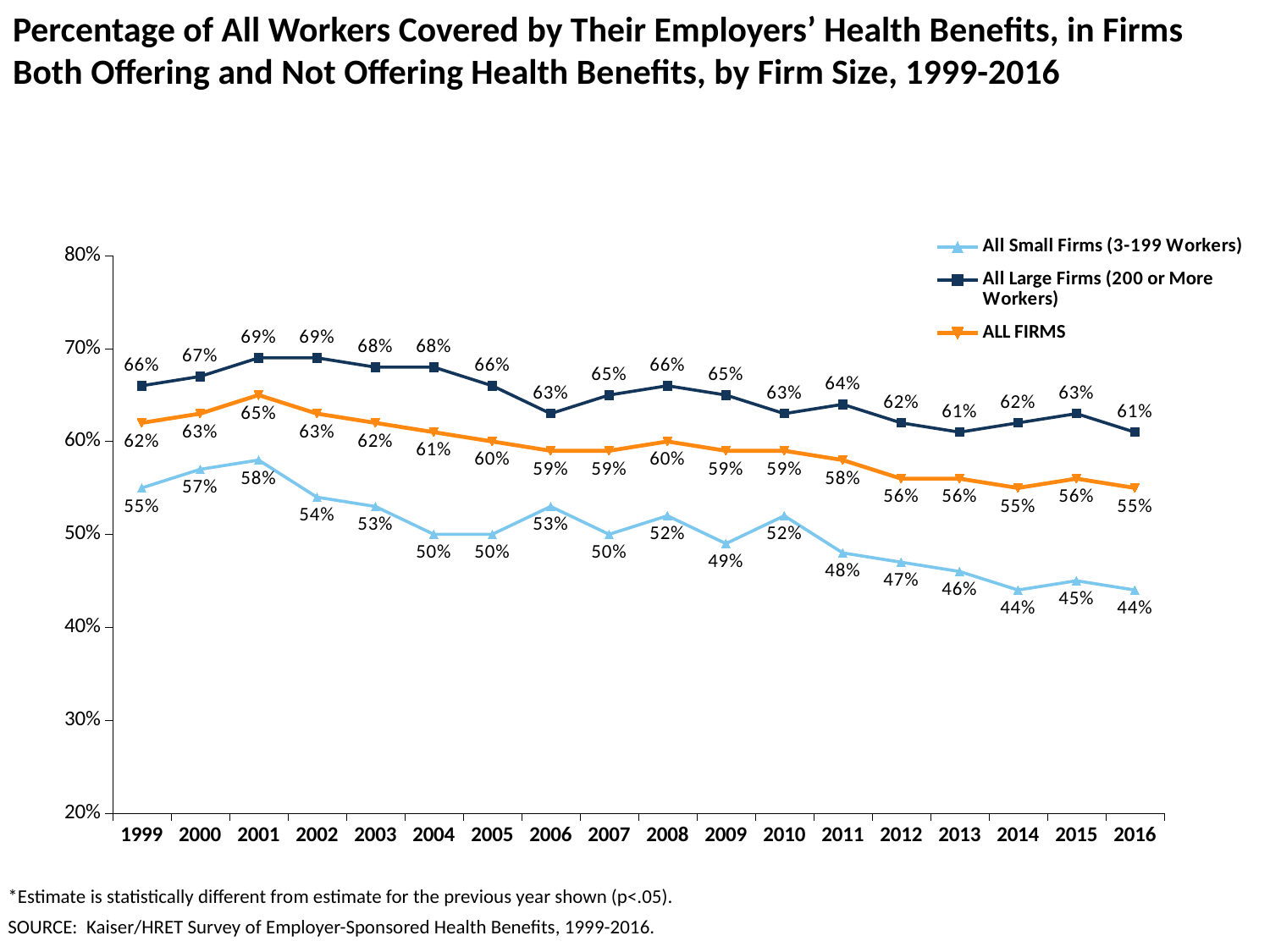
What is the difference in percentage points between All Large Firms and All Small Firms in 2016? 17 percentage points What was the coverage percentage for ALL FIRMS in 2012? 56% What kind of chart is shown on the slide? Line chart What percentage of workers in all small firms (3-199 workers) were covered by their employers' health benefits in 2016? 44% In which year did the ALL FIRMS series reach its highest value? 2001 Which was higher in 2009: the All Small Firms value or the ALL FIRMS value? ALL FIRMS How many years are shown on the x axis? 18 By how many percentage points did the All Small Firms value fall from 1999 to 2016? 11 percentage points What was the coverage percentage for all large firms (200 or more workers) in 2001? 69% How many series does the legend list? 3 Does the All Large Firms series generally rise or fall from 1999 to 2016? Fall In which year did the All Small Firms series reach its highest value? 2001